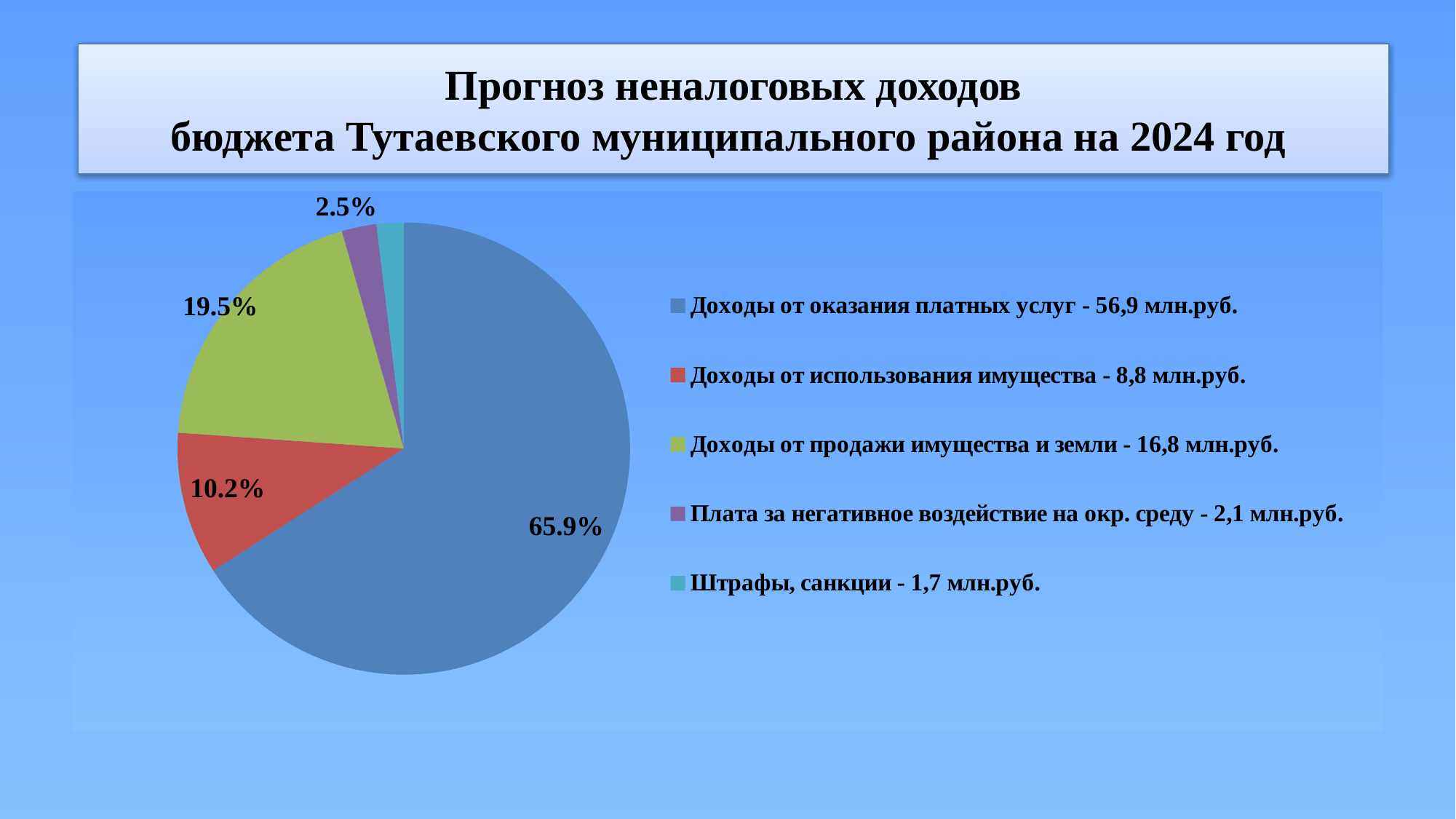
What colour is the slice for Доходы от оказания платных услуг? Blue Which category has the largest slice of the pie? Доходы от оказания платных услуг What share of the pie is labelled for Доходы от продажи имущества и земли? 19.5% According to the legend, what is the value for Плата за негативное воздействие на окр. среду? 2,1 млн.руб. What kind of chart is shown on the slide? Pie chart What is the difference between Доходы от оказания платных услуг (56,9 млн.руб.) and Доходы от продажи имущества и земли (16,8 млн.руб.)? 40,1 млн.руб. How many slices does the pie chart have? 5 According to the legend, what is the value for Доходы от использования имущества? 8,8 млн.руб. Which is larger: Доходы от продажи имущества и земли or Доходы от использования имущества? Доходы от продажи имущества и земли Which category has the smallest slice of the pie? Штрафы, санкции What share of the pie is labelled for Доходы от оказания платных услуг? 65.9% What share of the pie is labelled for Доходы от использования имущества? 10.2%